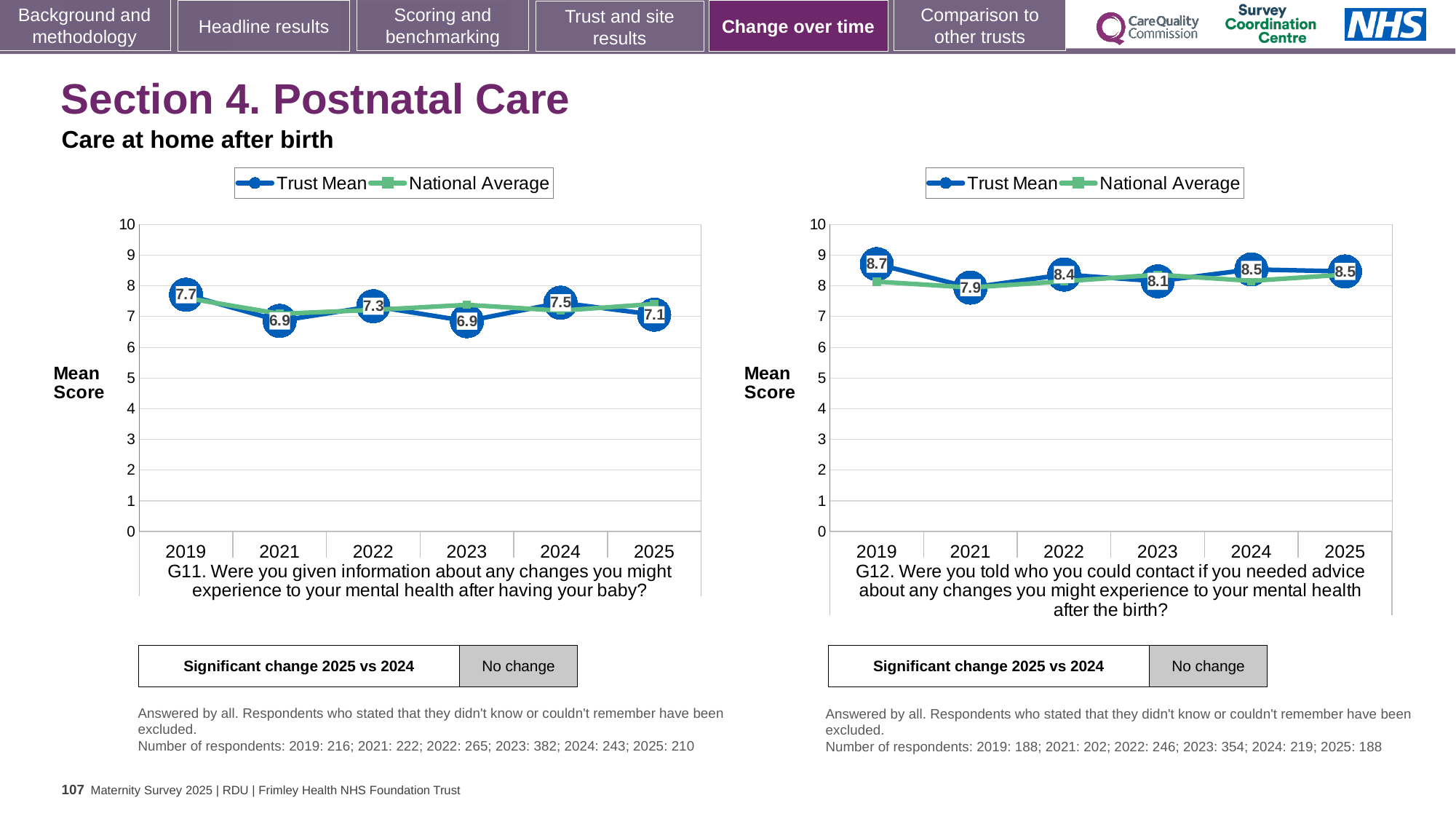
In the G11 chart, is the National Average for 2019 greater or less than 7? greater In the G12 chart, what is the Trust Mean for 2021? 7.9 In the G12 chart, which year has the lowest Trust Mean? 2021 How many series does the legend of the G12 chart list? 2 How many years are plotted on the x axis of the G11 chart? 6 What kind of chart is the G11 chart? Line chart In the G11 chart, which year has the highest Trust Mean? 2019 In the G11 chart, what is the Trust Mean for 2019? 7.7 In the G12 chart, is the Trust Mean higher in 2022 or in 2023? 2022 In the G12 chart, what is the difference between the Trust Mean in 2019 and in 2021? 0.8 In the G11 chart, what is the difference between the Trust Mean in 2019 and in 2025? 0.6 In the G12 chart, does the Trust Mean rise or fall from 2019 to 2021? Fall